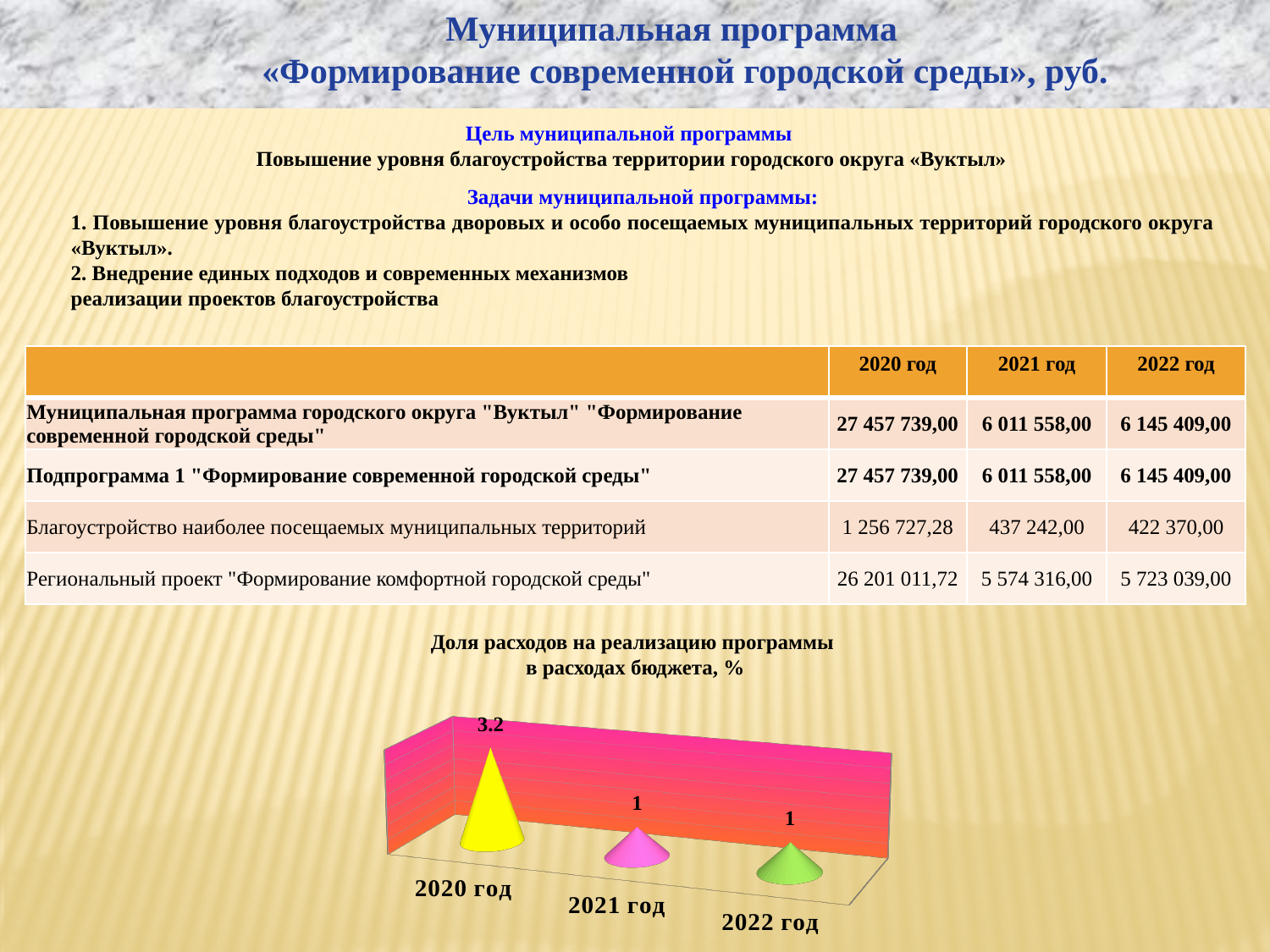
What is the title of the chart? Доля расходов на реализацию программы в расходах бюджета, % How many years are shown in the chart? 3 What is the value for 2020 год in the chart 'Доля расходов на реализацию программы в расходах бюджета, %'? 3.2 Which year has the highest value in the chart? 2020 год What is the value for 2021 год in the chart? 1 What is the value for 2022 год in the chart? 1 Does the value rise or fall from 2020 год to 2021 год? fall Which is larger, the value for 2020 год or the value for 2022 год? 2020 год What is the difference between the values for 2020 год and 2021 год? 2.2 What kind of chart is shown on the slide? bar chart What colour is the bar for 2020 год? yellow